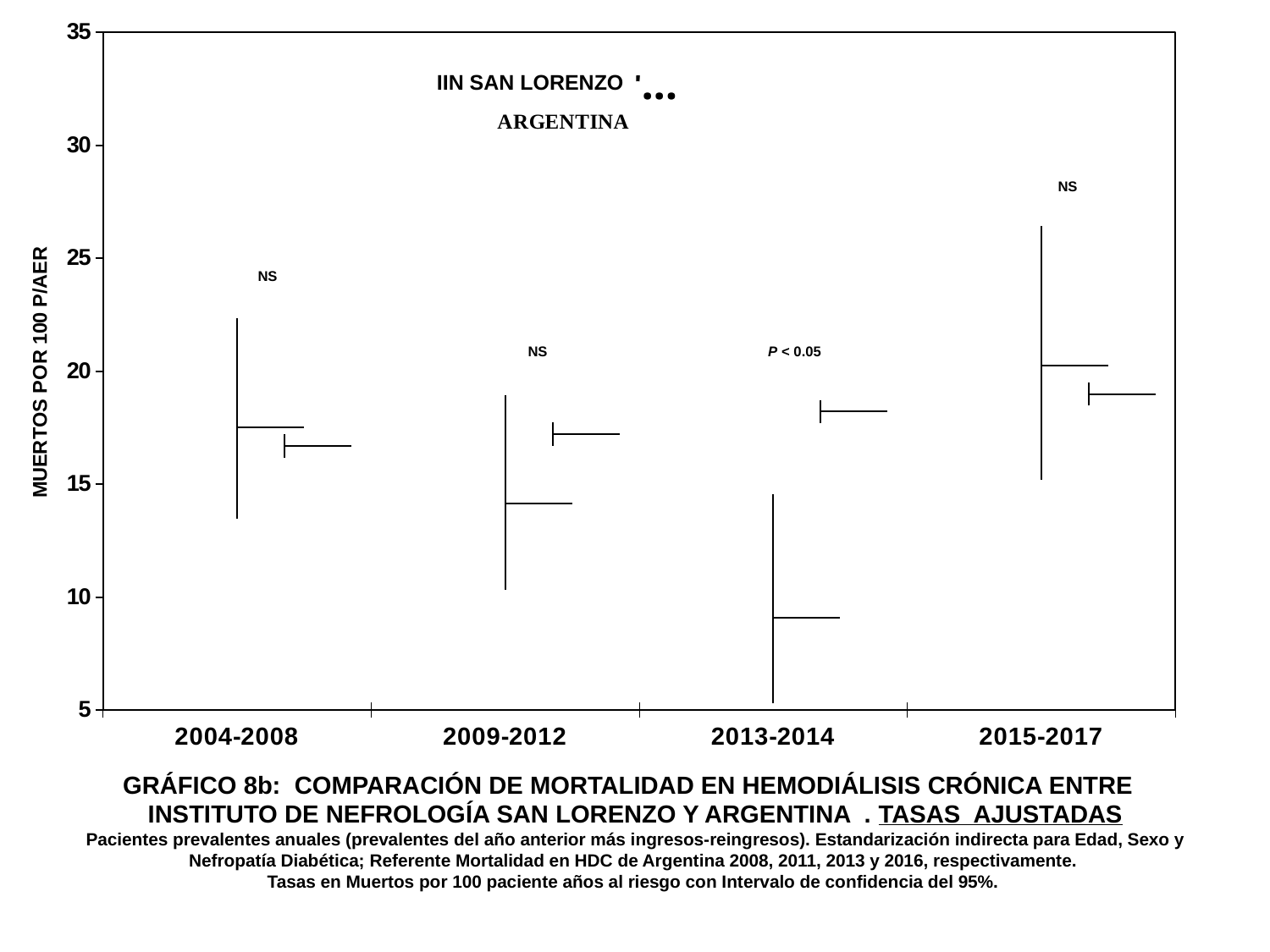
Which period is marked with 'P < 0.05'? 2013-2014 In which period is the IIN SAN LORENZO value lowest? 2013-2014 How many series does the legend list? 2 Is the ARGENTINA value for 2009-2012 greater or less than 15? greater Is the IIN SAN LORENZO value for 2009-2012 greater or less than 15? less How many time periods are shown on the x axis? 4 Is the IIN SAN LORENZO value for 2013-2014 greater or less than 10? less What is the label of the y axis? MUERTOS POR 100 P/AER In which period is the IIN SAN LORENZO value highest? 2015-2017 In 2013-2014, which is larger, the IIN SAN LORENZO value or the ARGENTINA value? ARGENTINA